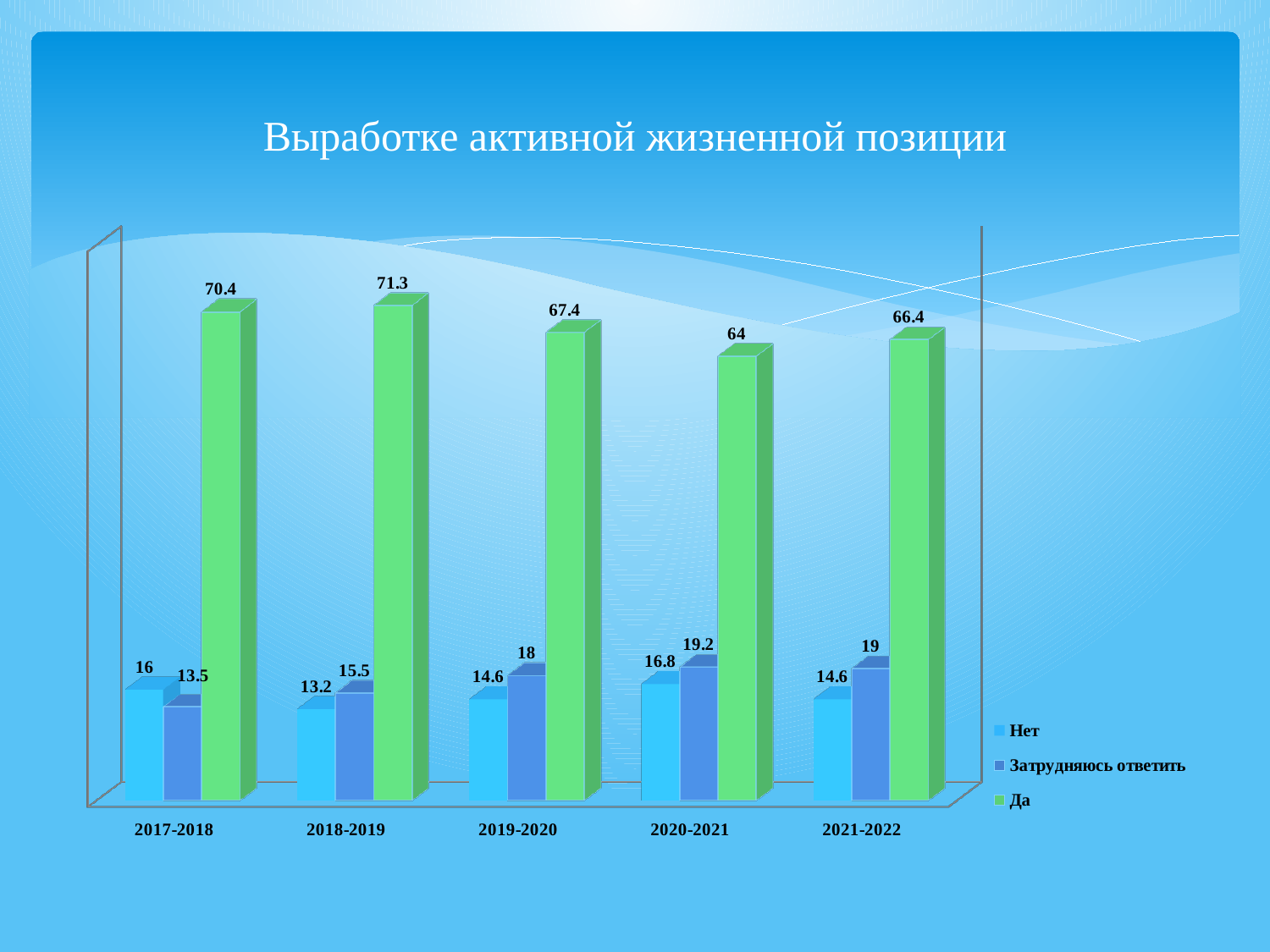
What is the value for "Да" in 2018-2019? 71.3 Does the value for "Затрудняюсь ответить" rise or fall from 2017-2018 to 2020-2021? Rise What is the value for "Нет" in 2020-2021? 16.8 In which period is the value for "Да" the highest? 2018-2019 What is the value for "Затрудняюсь ответить" in 2019-2020? 18 What kind of chart is shown on the slide? Bar chart In which period is the value for "Да" the lowest? 2020-2021 How many series does the legend list? 3 How many periods are shown on the x axis? 5 Which is larger in 2021-2022: "Нет" or "Затрудняюсь ответить"? Затрудняюсь ответить What is the difference between the "Да" values for 2017-2018 and 2021-2022? 4 What is the title of the chart? Выработке активной жизненной позиции